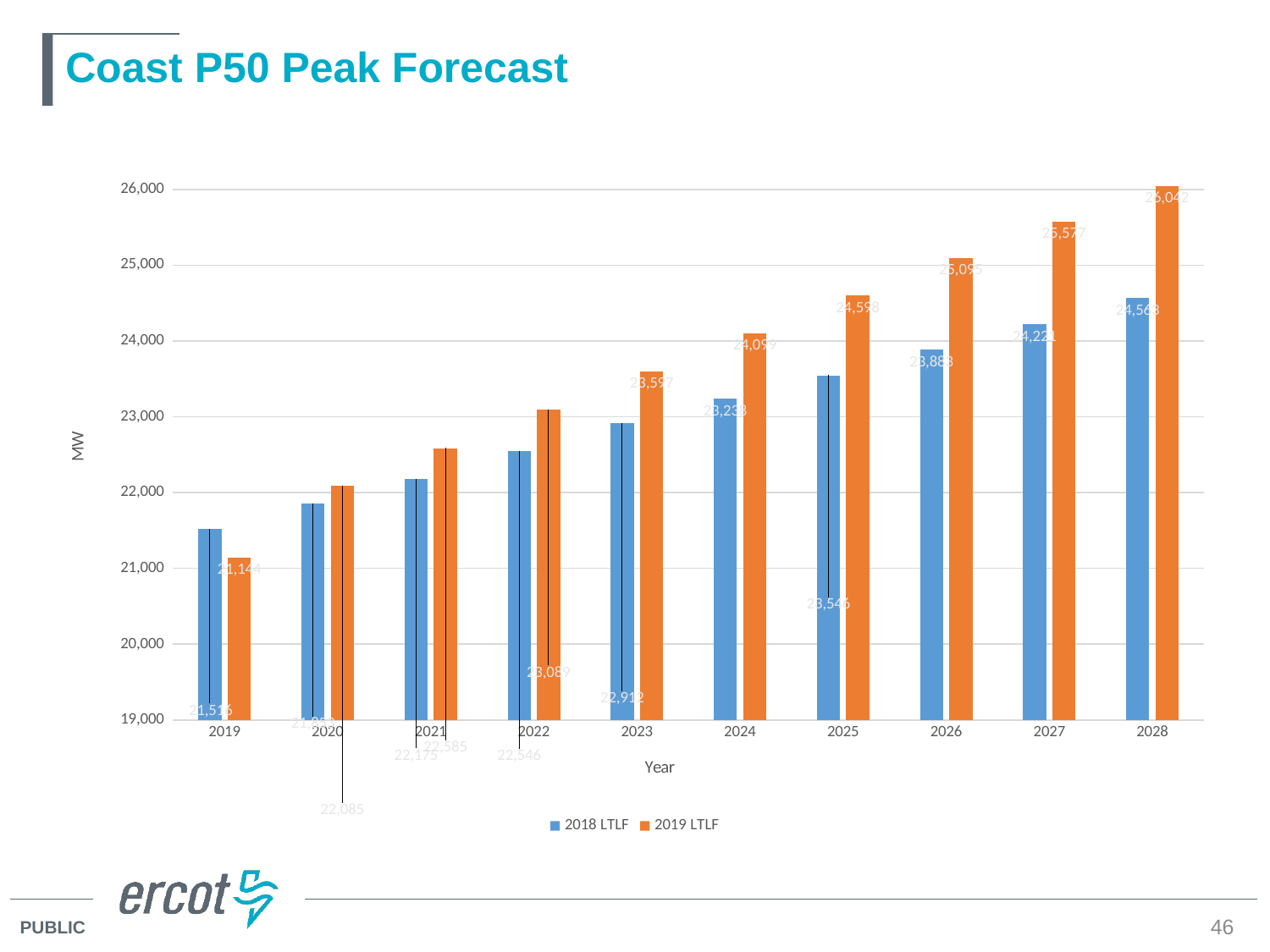
What is the 2019 LTLF value for 2020? 22,085 How many series does the legend list? 2 What is the 2019 LTLF value for 2028? 26,042 How many years are shown on the x axis? 10 What is the 2018 LTLF value for 2019? 21,516 What is the label on the y axis? MW Is the 2019 LTLF value for 2027 greater or less than 25,000? greater Which year has the highest 2019 LTLF value? 2028 For 2019, which series has the larger value, 2018 LTLF or 2019 LTLF? 2018 LTLF Do the 2019 LTLF values rise or fall from 2019 to 2028? Rise What kind of chart is shown on the slide? Bar chart What is the difference between the 2019 LTLF and 2018 LTLF values for 2021? 410